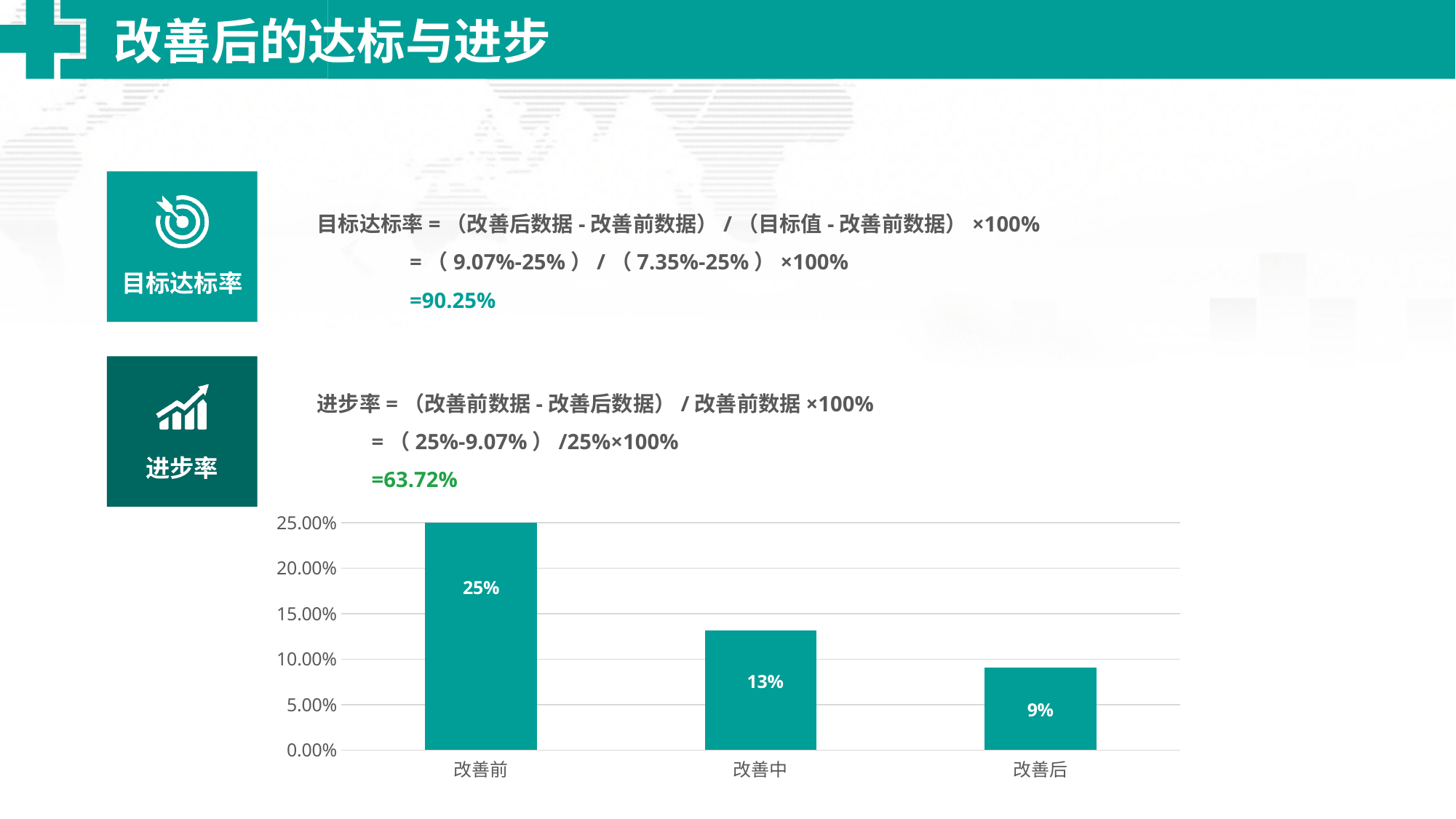
Do the values rise or fall from 改善前 to 改善后 along the x axis? fall What is the value for 改善中 in the bar chart? 13% Which is larger, the value for 改善中 or the value for 改善后? 改善中 Which category has the highest value in the bar chart? 改善前 What kind of chart is shown on the slide? bar chart Is the value for 改善中 greater or less than 10.00%? greater How many categories are shown on the x axis of the bar chart? 3 What is the value for 改善后 in the bar chart? 9% Which category has the lowest value in the bar chart? 改善后 What is the value for 改善前 in the bar chart? 25% What is the difference between the values for 改善前 and 改善后? 16% What is the difference between the values for 改善中 and 改善后? 4%